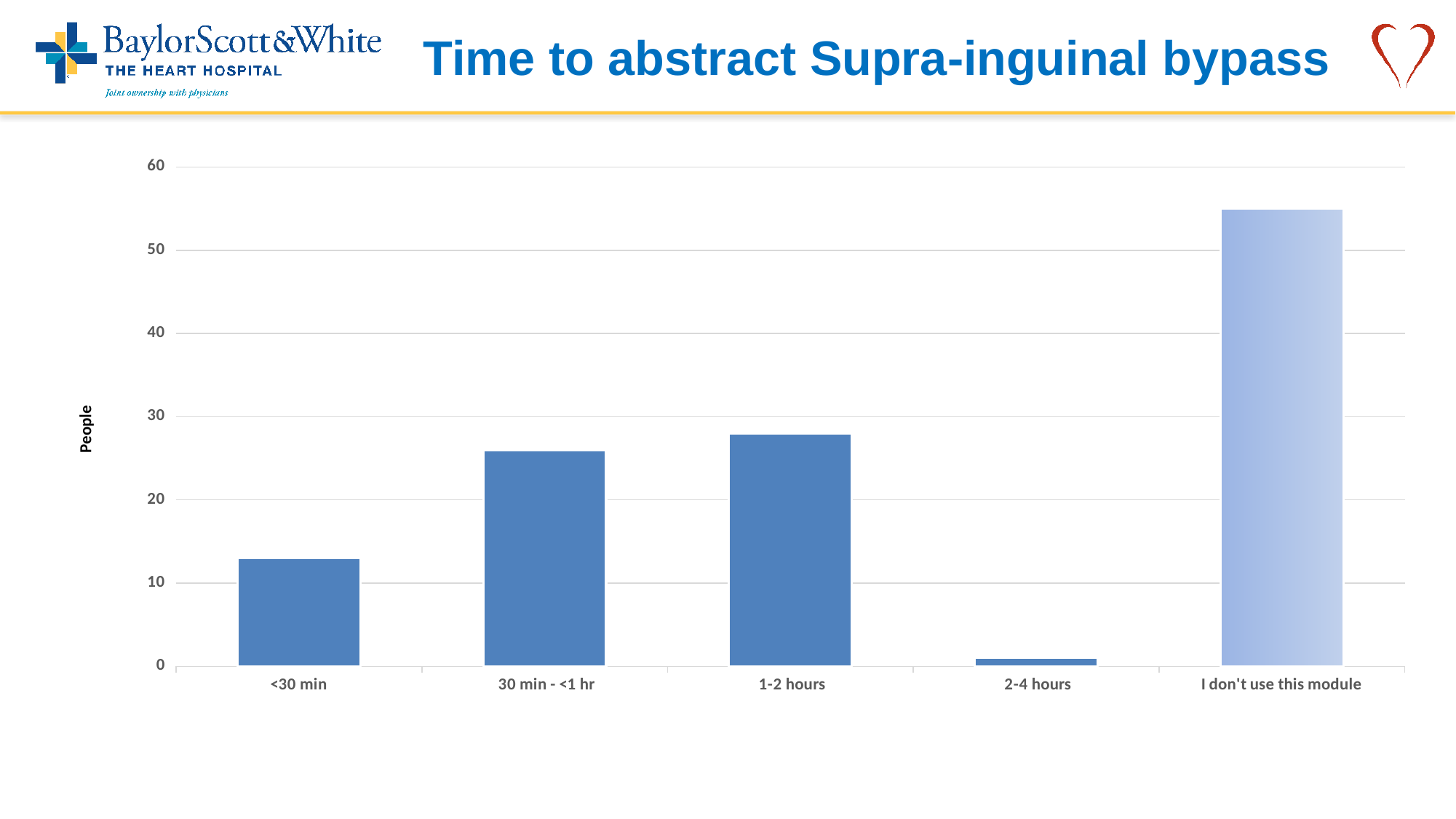
Is the value for "30 min - <1 hr" greater or less than 20? greater Is the value for "<30 min" greater or less than 20? less What is the title of the slide containing the chart? Time to abstract Supra-inguinal bypass Is the value for "1-2 hours" greater or less than 30? less How many categories are shown on the x axis of the chart? 5 What is the label on the y axis of the chart? People Which category has the highest value in the chart? I don't use this module Which category has the lowest value in the chart? 2-4 hours What kind of chart is shown on the slide? bar chart Which is larger, the value for "<30 min" or the value for "1-2 hours"? 1-2 hours